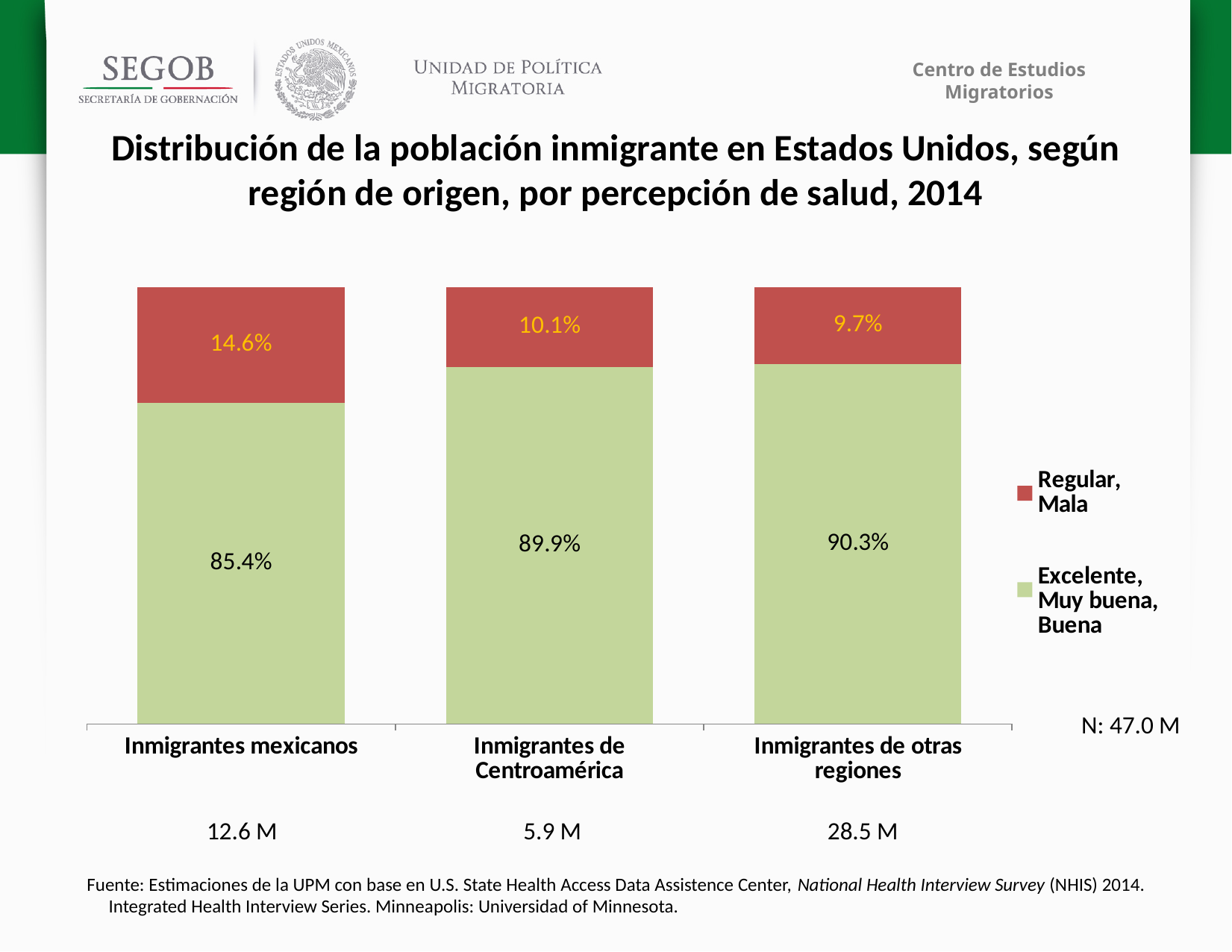
How many groups of immigrants are shown on the x axis? 3 What is the difference in the Regular, Mala share between Inmigrantes mexicanos and Inmigrantes de otras regiones? 4.9 percentage points What percentage of Inmigrantes de otras regiones report Regular, Mala health? 9.7% What kind of chart is shown on the slide? Stacked bar chart What percentage of Inmigrantes mexicanos report Regular, Mala health? 14.6% Which group has the highest share of Regular, Mala health perception? Inmigrantes mexicanos Which group has the lowest share of Excelente, Muy buena, Buena health perception? Inmigrantes mexicanos How many series does the legend list? 2 What percentage of Inmigrantes de Centroamérica report Excelente, Muy buena, Buena health? 89.9% Which is larger: the Excelente, Muy buena, Buena share for Inmigrantes de Centroamérica or for Inmigrantes mexicanos? Inmigrantes de Centroamérica What population size is shown below the bar for Inmigrantes de Centroamérica? 5.9 M What is the total of the two segments in the bar for Inmigrantes de otras regiones? 100%